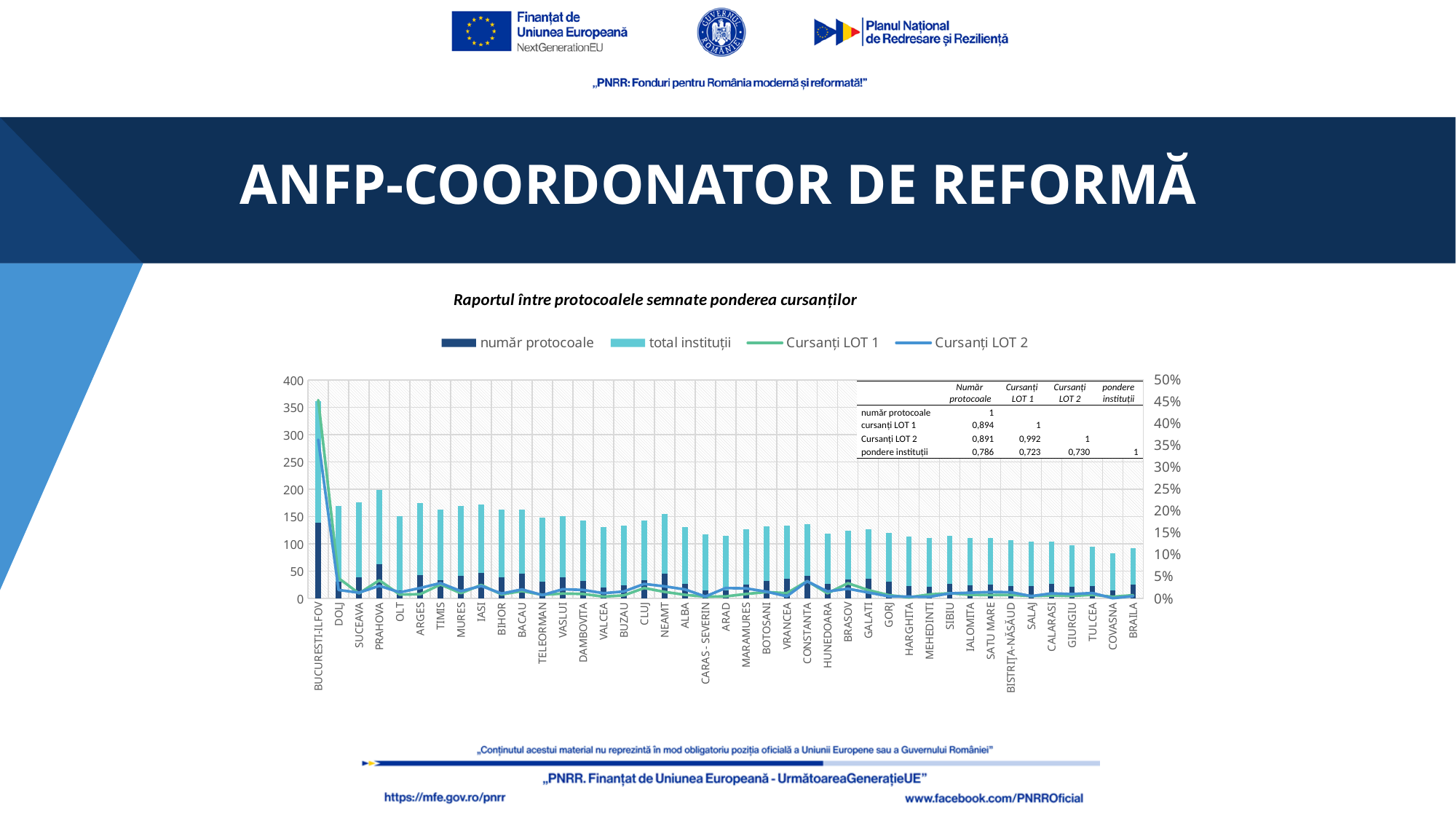
Is the număr protocoale value for BUCURESTI-ILFOV greater or less than 100? greater What kind of chart is this? Combined bar and line chart Is the total instituții value for COVASNA greater or less than 100? less How many series does the chart legend list? 4 In the table inset, what is the value in the row cursanți LOT 1 under the column Număr protocoale? 0,894 Is the total instituții value for BUCURESTI-ILFOV greater or less than 300? less How many counties (categories) are shown on the x axis? 41 Which county has the highest value for număr protocoale? BUCURESTI-ILFOV What is the title of the chart? Raportul între protocoalele semnate ponderea cursanților Do the total instituții values generally rise or fall from left to right along the x axis? fall Which county has the highest value for total instituții? BUCURESTI-ILFOV